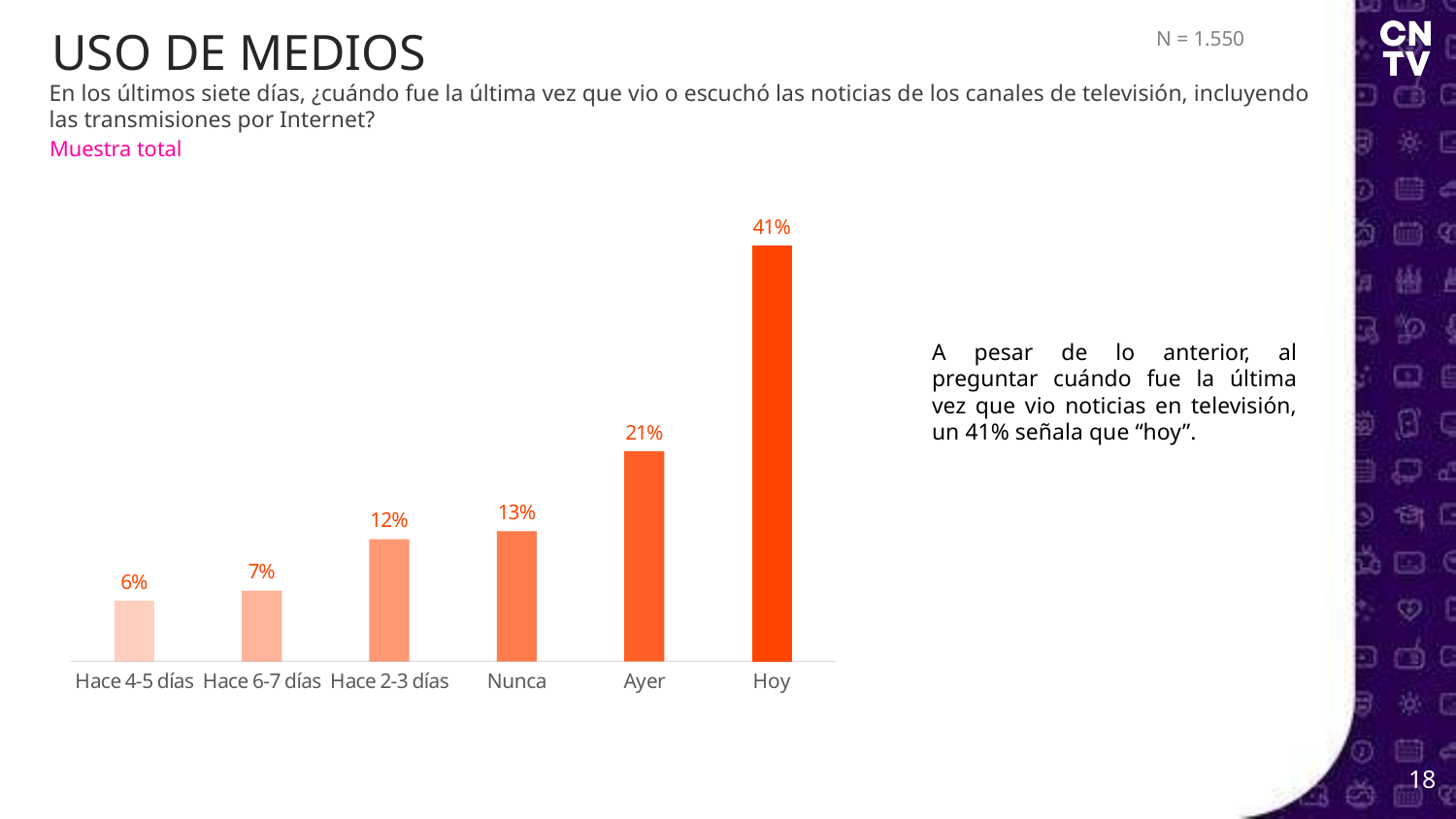
What is the value for "Nunca"? 13% What is the value for "Ayer"? 21% How many categories are shown on the x axis? 6 What is the difference between the values for "Hoy" and "Ayer"? 20% What is the value for "Hoy"? 41% Which category has the highest value? Hoy Which is larger, the value for "Nunca" or the value for "Hace 2-3 días"? Nunca Which category has the lowest value? Hace 4-5 días What kind of chart is shown on the slide? Bar chart Do the values rise or fall from left to right along the x axis? Rise What is the difference between the values for "Hace 6-7 días" and "Hace 4-5 días"? 1% What is the value for "Hace 2-3 días"? 12%